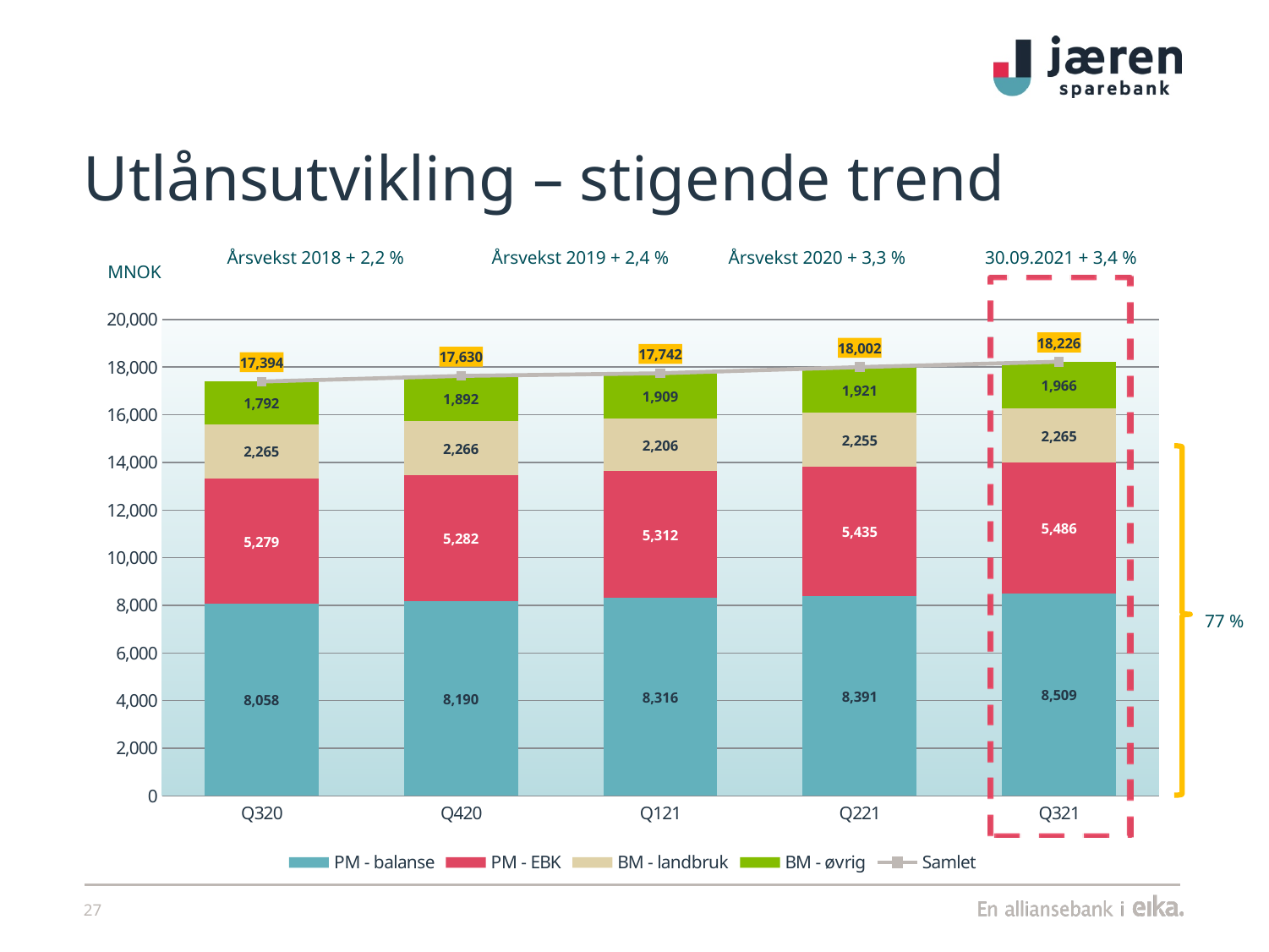
What kind of chart is shown on the slide? Stacked bar chart with a line How many series does the legend list? 5 Which is larger, PM - EBK for Q221 or PM - EBK for Q121? Q221 Does the Samlet line rise or fall from Q320 to Q321? Rise What is the value of PM - balanse for Q321? 8,509 What is the title of the slide? Utlånsutvikling – stigende trend Which quarter has the highest Samlet value? Q321 What is the value of BM - landbruk for Q121? 2,206 What is the Samlet value for Q221? 18,002 How many quarters are shown on the x axis? 5 What is the difference between the Samlet values for Q321 and Q320? 832 Which quarter has the lowest PM - balanse value? Q320